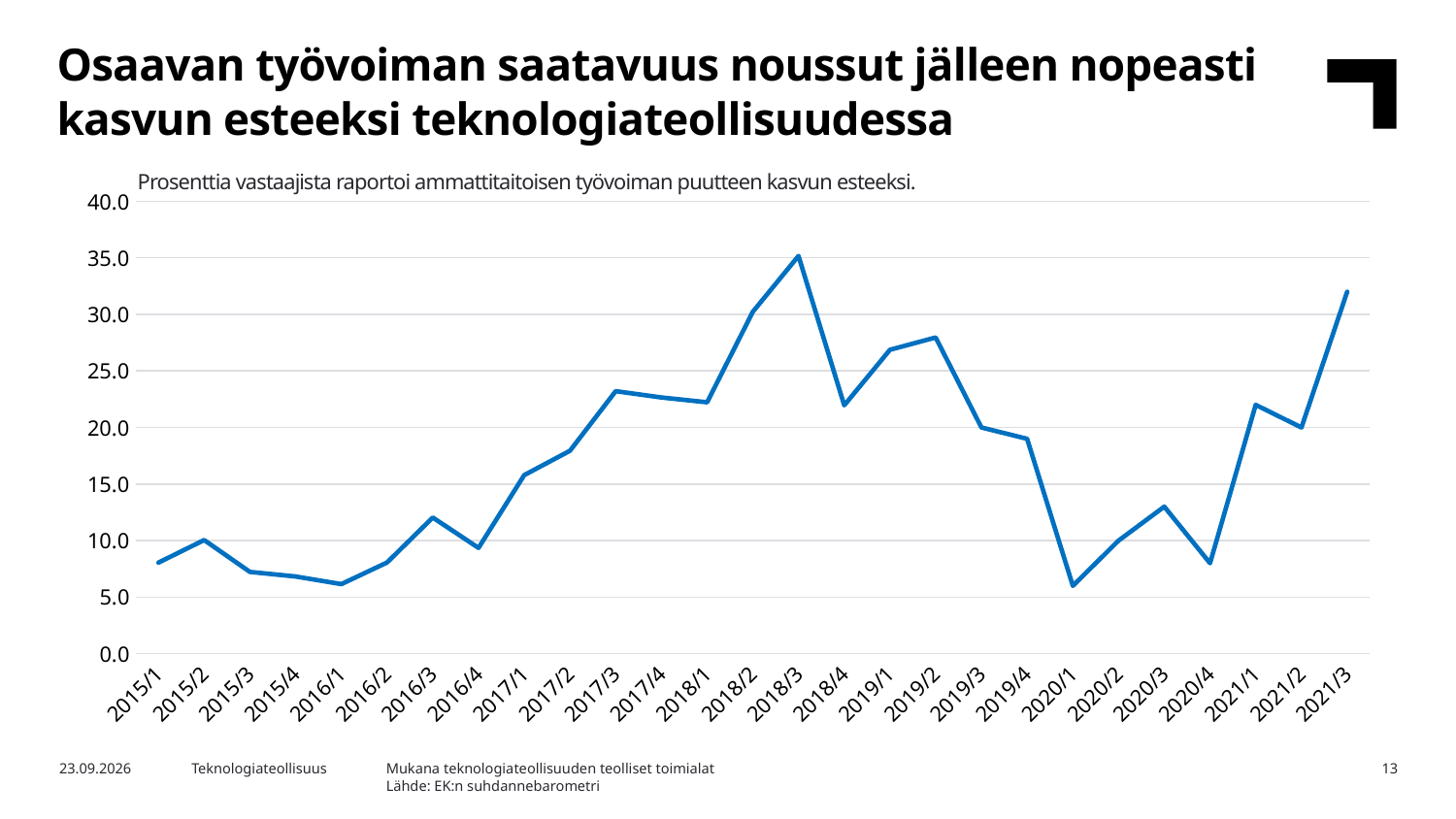
Which is larger, the value for 2019/4 or the value for 2020/1? 2019/4 What is the subtitle text shown above the chart? Prosenttia vastaajista raportoi ammattitaitoisen työvoiman puutteen kasvun esteeksi. Is the value for 2015/1 greater or less than 10.0? less Is the value for 2019/2 greater or less than 25.0? greater Is the value for 2018/3 greater or less than 30.0? greater Do the values rise or fall from 2019/2 to 2020/1? fall Which quarter has the highest value on the chart? 2018/3 Which is larger, the value for 2018/3 or the value for 2021/3? 2018/3 How many quarterly data points are plotted along the x axis? 27 What kind of chart is shown on the slide? line chart